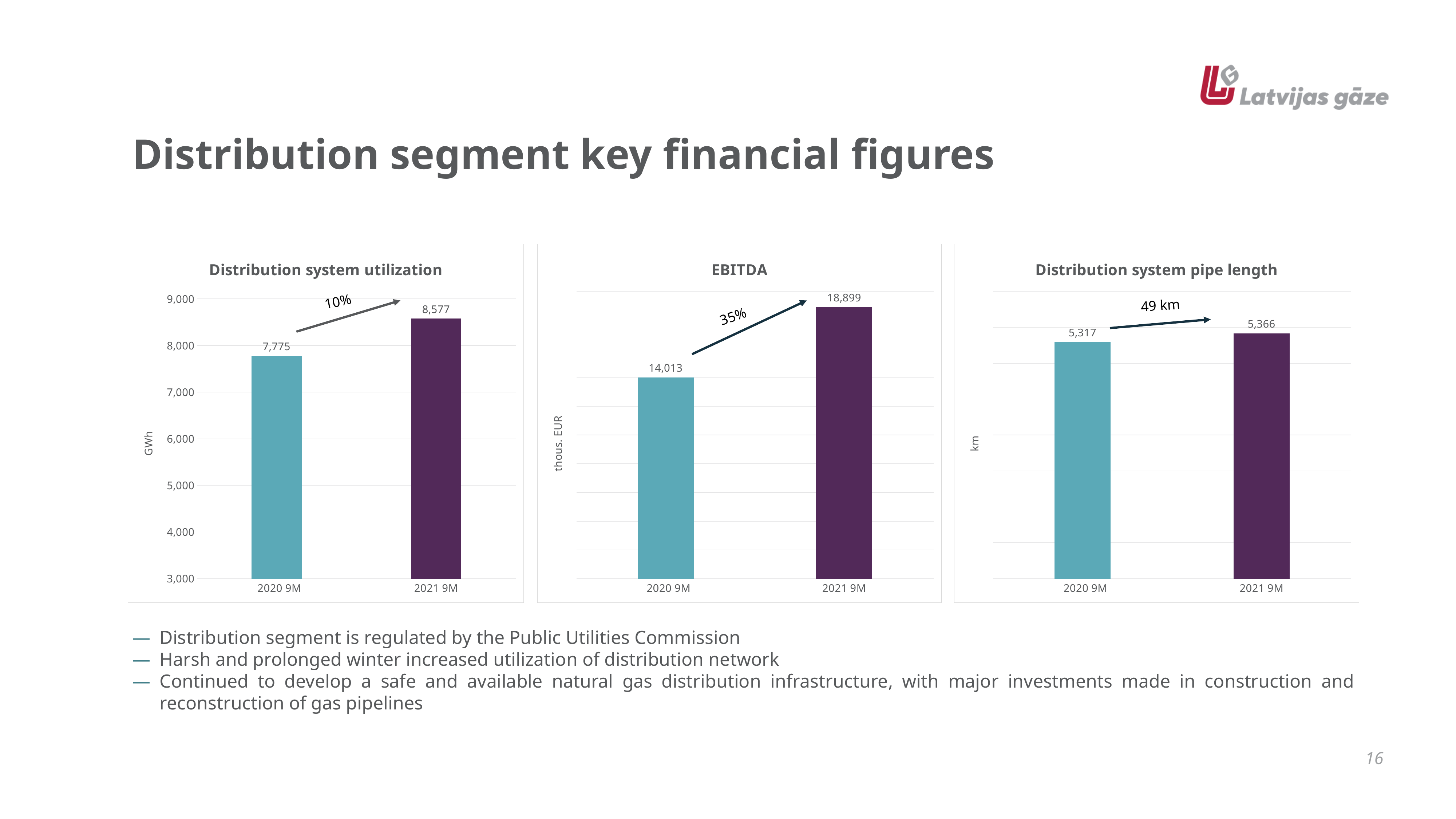
What kind of chart is the EBITDA chart? bar chart In the Distribution system utilization chart, which period has the higher value? 2021 9M In the EBITDA chart, what is the value for 2020 9M? 14,013 What unit is shown on the y axis of the Distribution system utilization chart? GWh In the EBITDA chart, what is the difference between the 2021 9M and 2020 9M values? 4,886 In the Distribution system utilization chart, is the value for 2020 9M greater or less than 8,000? less In the EBITDA chart, what is the value for 2021 9M? 18,899 In the Distribution system utilization chart, what is the value for 2020 9M? 7,775 In the Distribution system utilization chart, what is the difference between the 2021 9M and 2020 9M values? 802 In the Distribution system pipe length chart, what is the value for 2021 9M? 5,366 In the Distribution system utilization chart, what is the value for 2021 9M? 8,577 In the Distribution system pipe length chart, what is the value for 2020 9M? 5,317